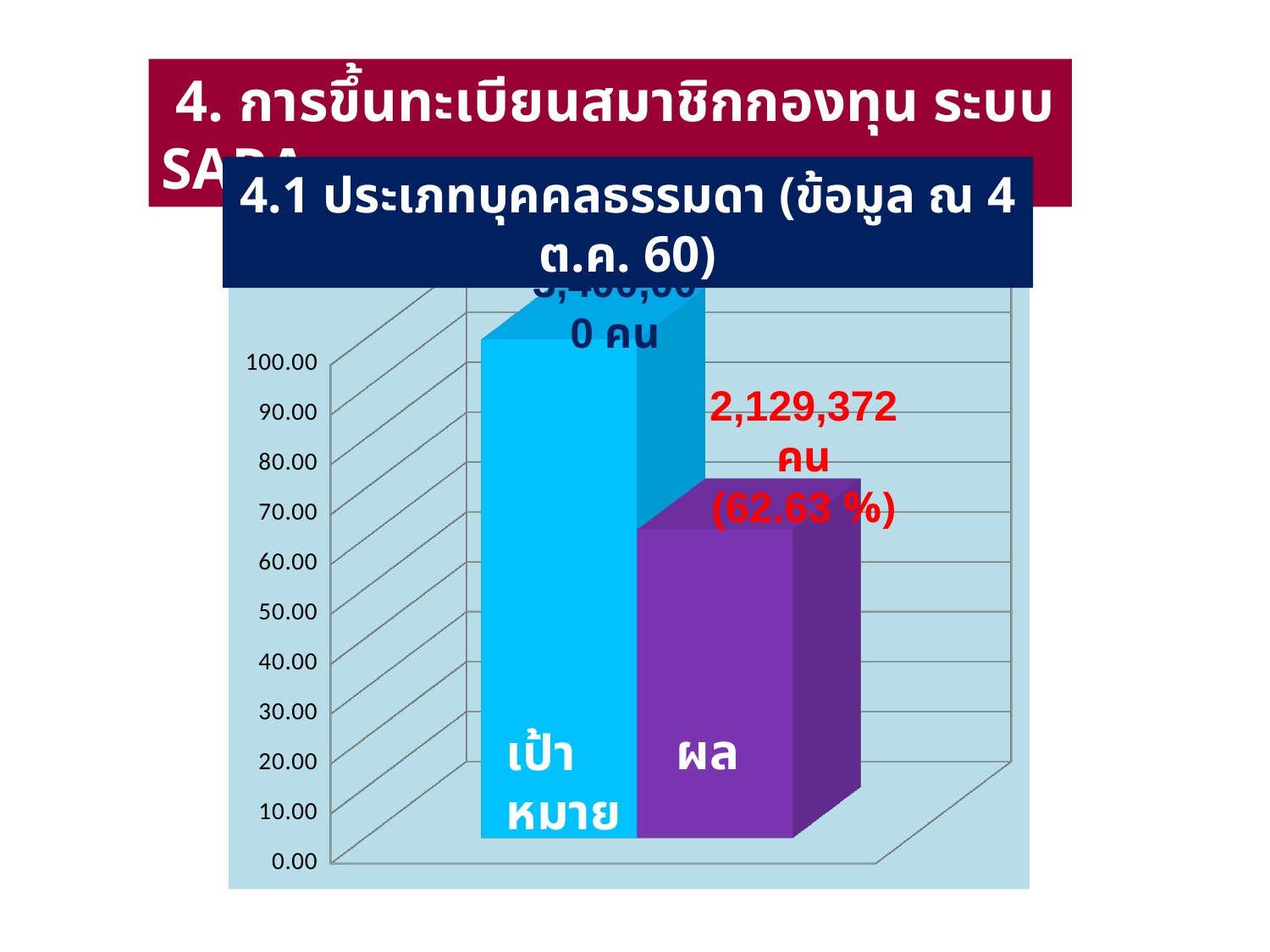
Which bar is the tallest? เป้าหมาย How many bars (categories) does the chart show? 2 Which bar is the shortest? ผล What value is labelled on the ผล bar? 2,129,372 คน Is the value for ผล on the axis greater or less than 50.00? greater What is the title of the chart? 4.1 ประเภทบุคคลธรรมดา (ข้อมูล ณ 4 ต.ค. 60) What kind of chart is shown on the slide? bar chart What percentage is shown in parentheses for the ผล bar? 62.63 % Which is larger, เป้าหมาย or ผล? เป้าหมาย Is the value for ผล on the axis greater or less than 70.00? less What is the highest tick value shown on the vertical axis? 100.00